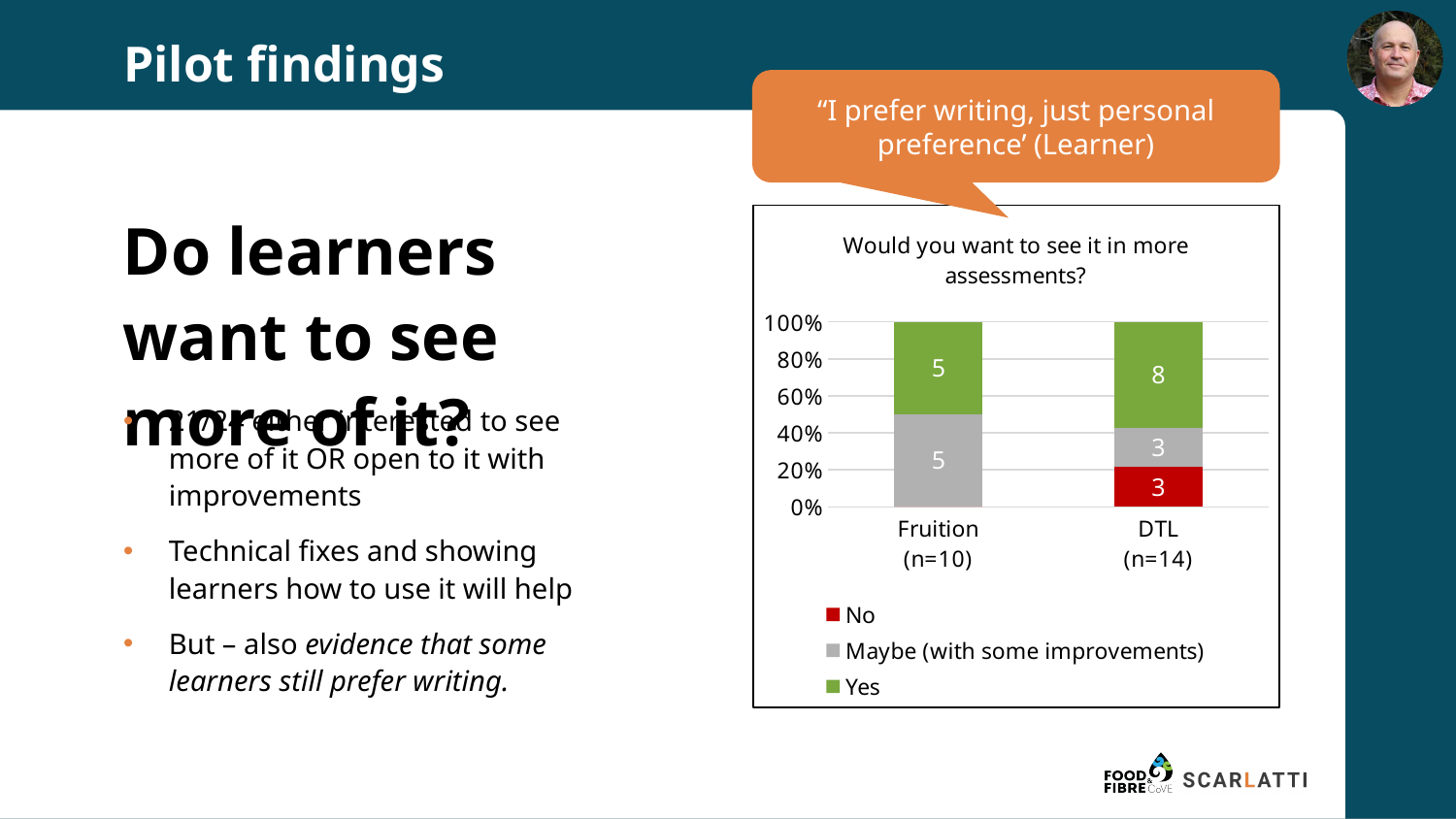
What is the value for Maybe (with some improvements) in the DTL (n=14) bar? 3 How many categories are shown on the x axis of the chart? 2 What is the title of the chart? Would you want to see it in more assessments? What is the value for Yes in the DTL (n=14) bar? 8 What is the value for Maybe (with some improvements) in the Fruition (n=10) bar? 5 Which category has the higher Yes value, Fruition (n=10) or DTL (n=14)? DTL (n=14) What is the value for Yes in the Fruition (n=10) bar? 5 How many series does the chart legend list? 3 What is the difference between the Yes values for DTL (n=14) and Fruition (n=10)? 3 What is the total of the labelled segments in the DTL (n=14) bar? 14 What kind of chart is shown on the slide? Stacked bar chart What is the value for No in the DTL (n=14) bar? 3